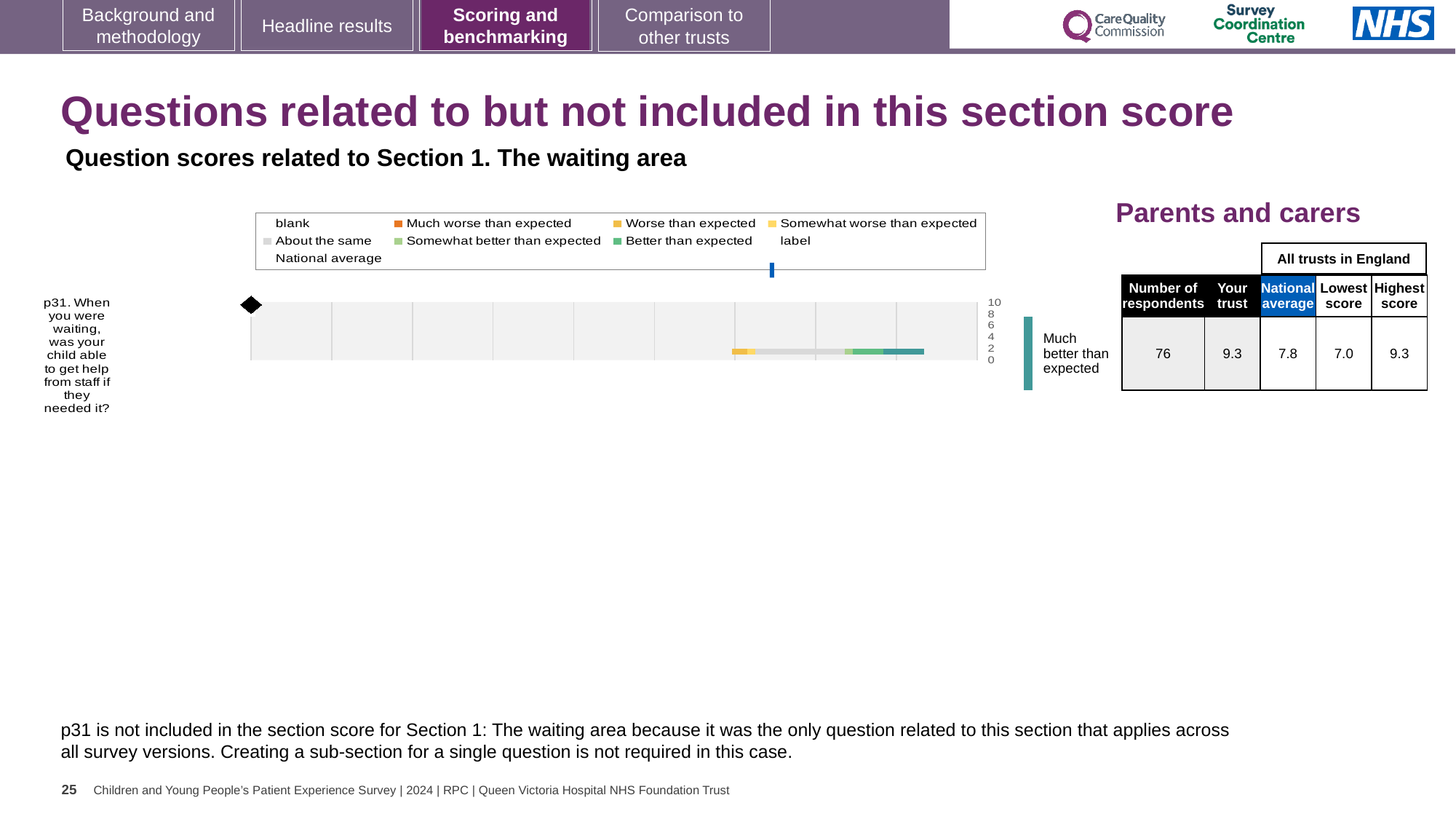
What is the highest score across all trusts in England for p31? 9.3 What kind of chart is used to show the p31 question score? Bar chart How many respondents answered p31 for this trust? 76 By how much does the 'Your trust' score for p31 exceed the national average? 1.5 Which question is plotted in the chart? p31. When you were waiting, was your child able to get help from staff if they needed it? Which legend entry is shown in orange? Much worse than expected What benchmark label is shown to the right of the p31 bar? Much better than expected How many survey questions are plotted in the chart? 1 What is the 'Your trust' score for p31 in the Parents and carers table? 9.3 Which is larger for p31: the 'Your trust' score or the national average? Your trust What is the national average score for p31 in the Parents and carers table? 7.8 What is the lowest score across all trusts in England for p31? 7.0